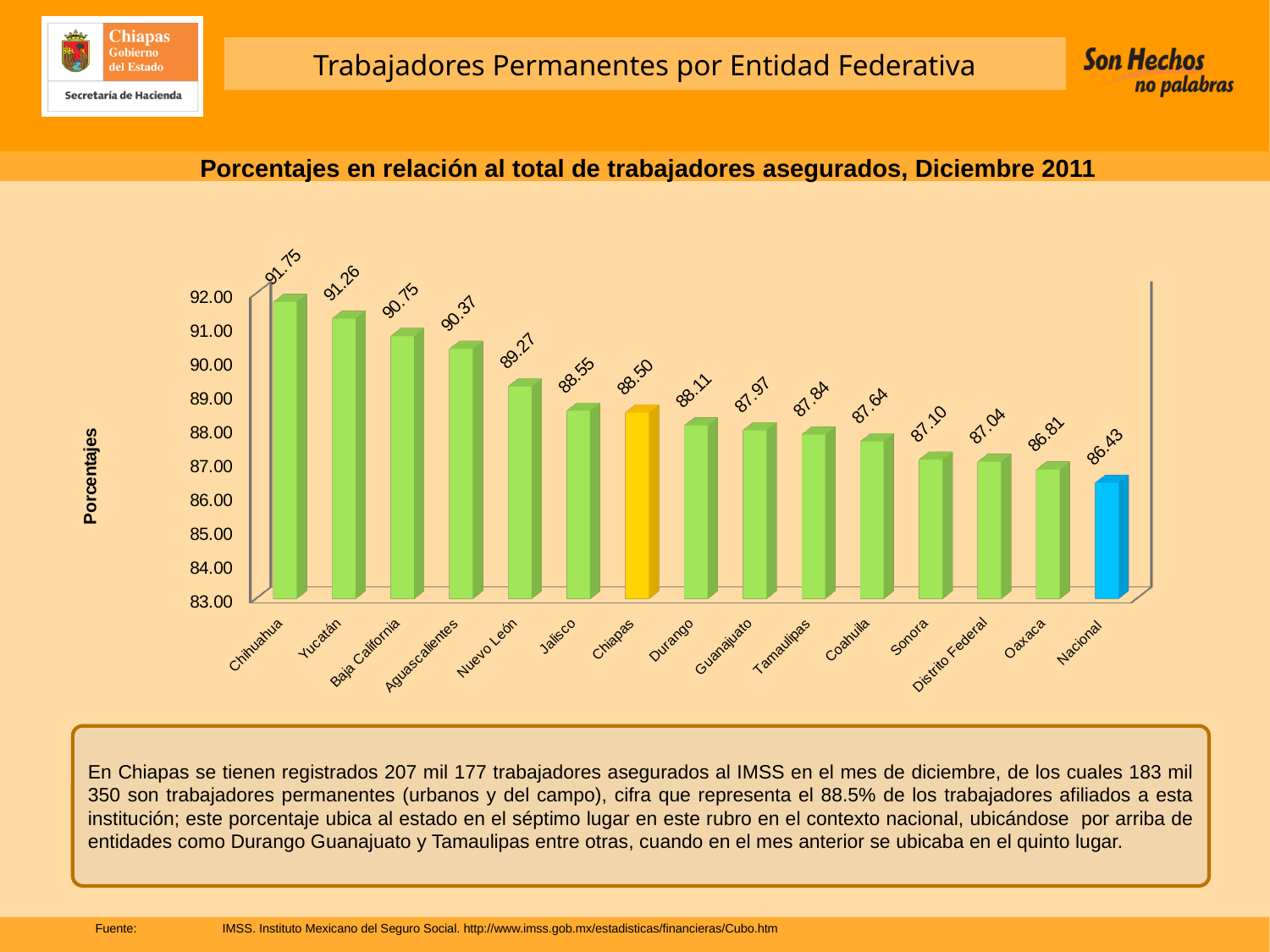
What is the difference between the values for Chiapas and Durango? 0.39 What kind of chart is shown on the slide? bar chart What is the value for Chiapas? 88.50 How many categories are shown on the x axis? 15 Is the value for Sonora greater or less than 88.00? less Which category has the highest value? Chihuahua What is the value for Nuevo León? 89.27 What is the difference between the values for Chihuahua and Nacional? 5.32 What is the value for Nacional? 86.43 Which is larger, the value for Yucatán or the value for Baja California? Yucatán What is the label of the y axis? Porcentajes Which category has the lowest value? Nacional